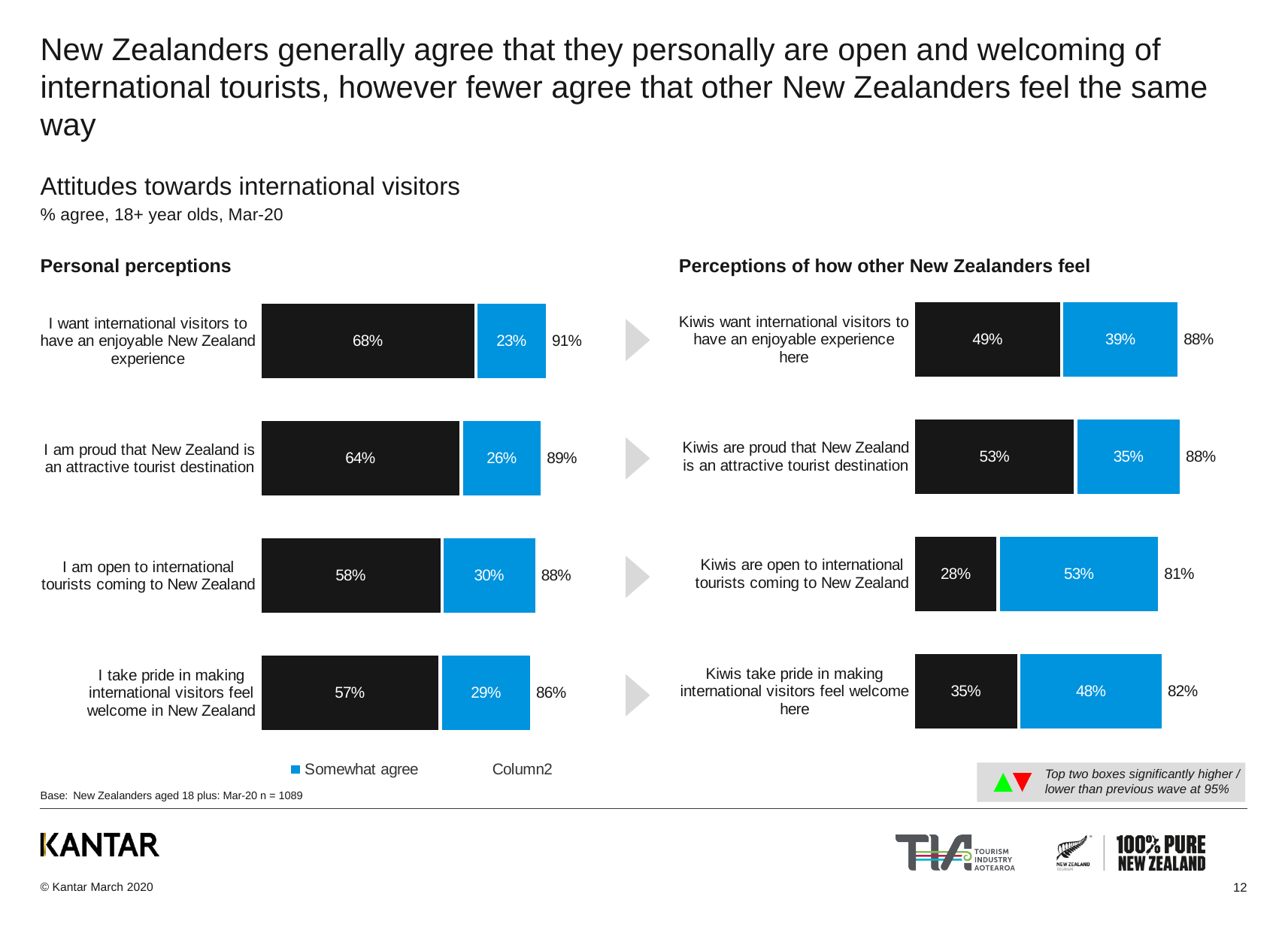
Which legend entry is shown in blue on the slide? Somewhat agree How many statements are shown in the Personal perceptions chart? 4 In the Perceptions of how other New Zealanders feel chart, what is the Somewhat agree value for "Kiwis are open to international tourists coming to New Zealand"? 53% In the Perceptions of how other New Zealanders feel chart, which has the larger dark segment value: "Kiwis want international visitors to have an enjoyable experience here" or "Kiwis are proud that New Zealand is an attractive tourist destination"? Kiwis are proud that New Zealand is an attractive tourist destination In the Personal perceptions chart, what is the Somewhat agree value for "I am open to international tourists coming to New Zealand"? 30% What is the difference between the total % agree for "I am open to international tourists coming to New Zealand" in the Personal perceptions chart and "Kiwis are open to international tourists coming to New Zealand" in the Perceptions of how other New Zealanders feel chart? 7 percentage points In the Personal perceptions chart, what is the total % agree shown for "I want international visitors to have an enjoyable New Zealand experience"? 91% In the Perceptions of how other New Zealanders feel chart, what is the difference between the Somewhat agree value and the dark segment value for "Kiwis are open to international tourists coming to New Zealand"? 25 percentage points In the Personal perceptions chart, which statement has the lowest total % agree? I take pride in making international visitors feel welcome in New Zealand In the Perceptions of how other New Zealanders feel chart, which statement has the lowest total % agree? Kiwis are open to international tourists coming to New Zealand In the Personal perceptions chart, which statement has the highest total % agree? I want international visitors to have an enjoyable New Zealand experience What type of chart is used for the Personal perceptions data? Stacked bar chart